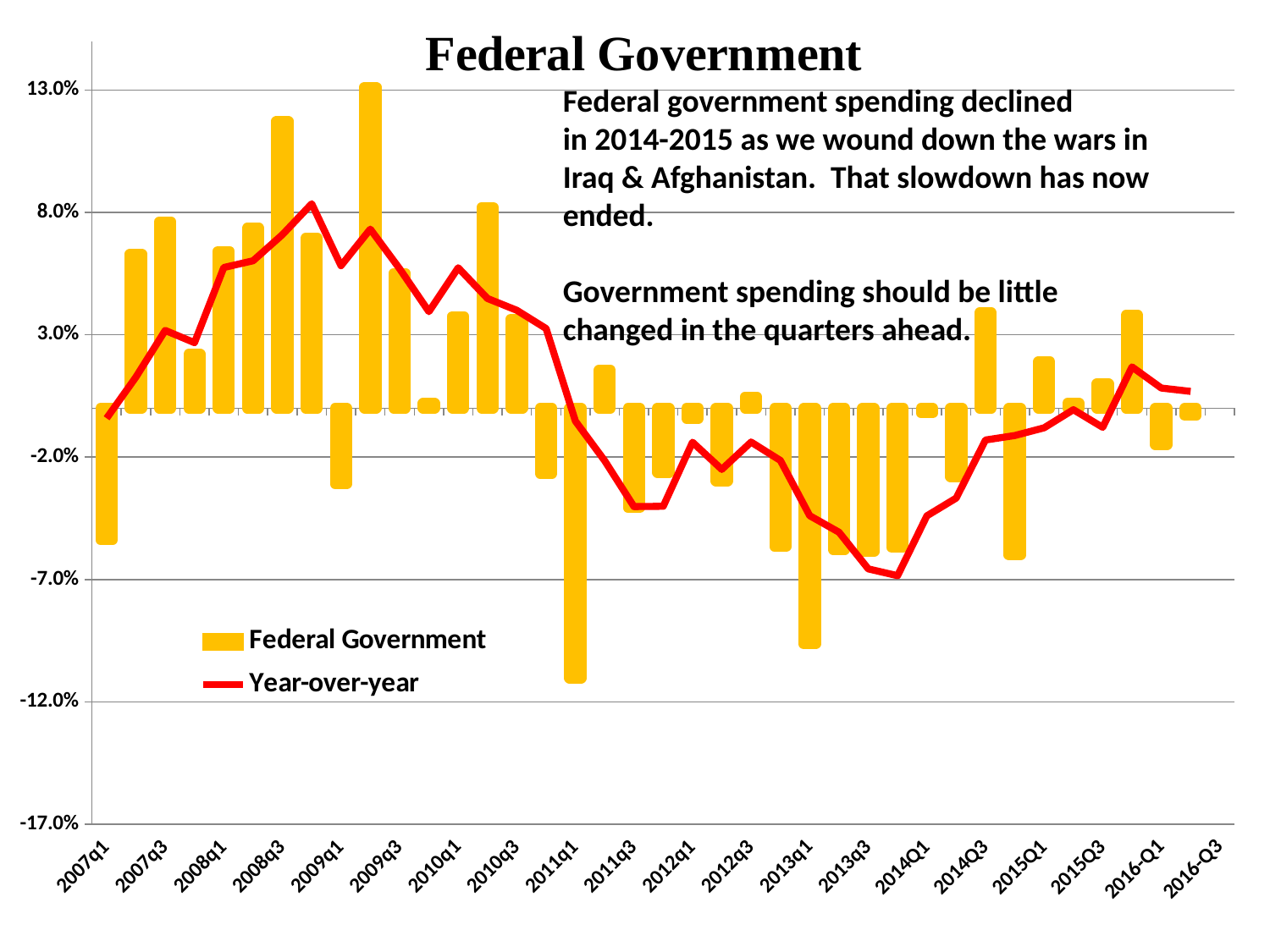
How many series does the legend list? 2 What are the two series named in the legend? Federal Government and Year-over-year Which is larger, the Federal Government bar for 2009q3 or for 2008q3? 2008q3 Does the Year-over-year line rise or fall between 2010q3 and 2011q3? fall Which quarter has the lowest Federal Government bar? 2011q1 How many quarter labels are shown on the x axis? 20 What kind of chart is shown on the slide? A combined bar and line chart Which quarter has the highest Federal Government bar? 2009q2 Is the Federal Government bar for 2013q1 greater or less than -7.0%? less Is the Federal Government bar for 2009q3 greater or less than 8.0%? less What is the title of the chart? Federal Government Is the Federal Government bar for 2011q1 greater or less than -7.0%? less